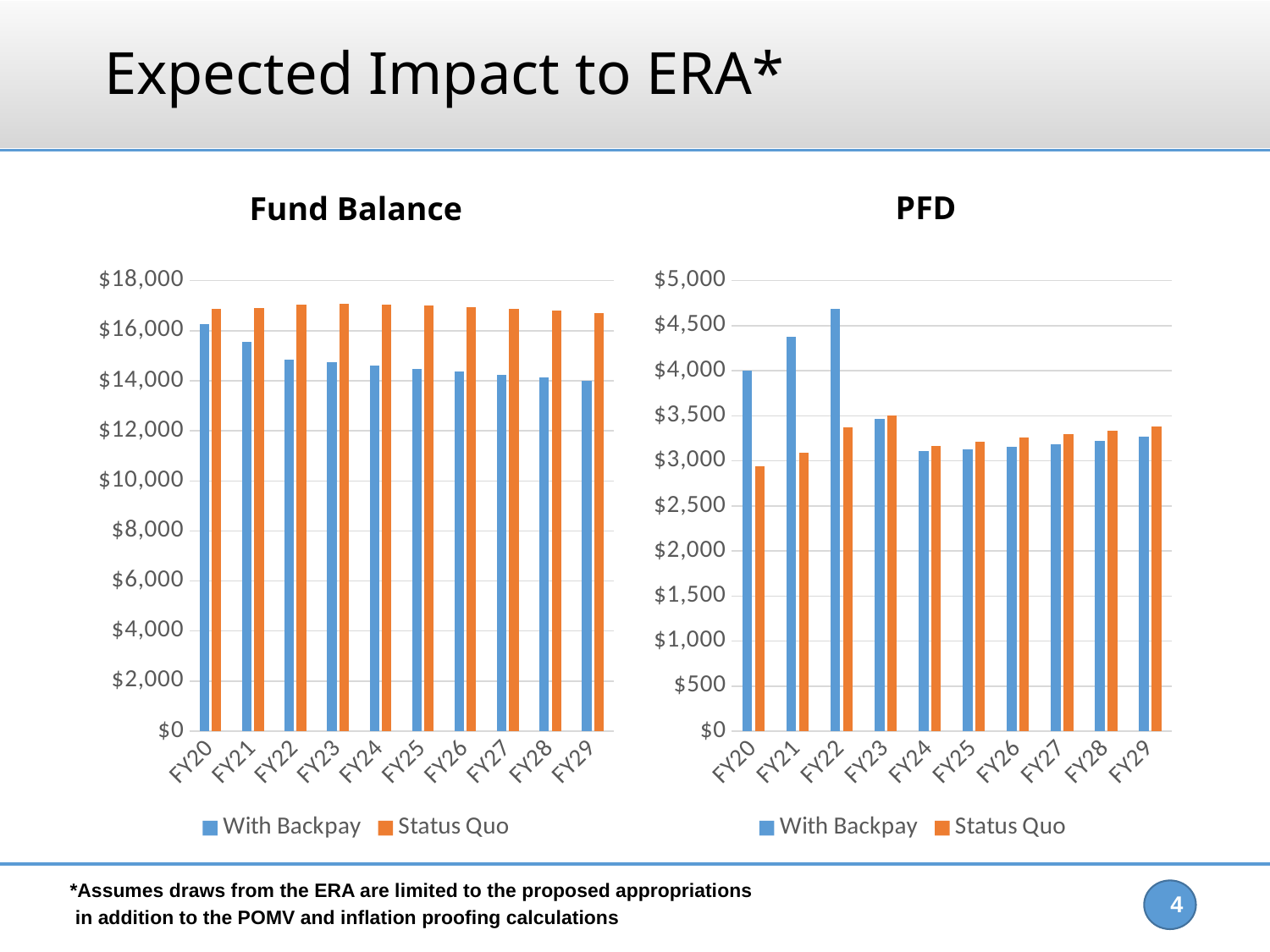
In the Fund Balance chart, do the With Backpay values rise or fall from FY20 to FY29? fall In the PFD chart, which fiscal year has the lowest Status Quo value? FY20 What kind of chart is the Fund Balance chart? bar chart In the Fund Balance chart, which series is larger in FY25, With Backpay or Status Quo? Status Quo In the PFD chart, is the Status Quo value for FY20 greater or less than $3,000? less In the Fund Balance chart, which fiscal year has the highest With Backpay value? FY20 In the Fund Balance chart, is the Status Quo value for FY23 greater or less than $16,000? greater In the PFD chart, which fiscal year has the highest With Backpay value? FY22 In the PFD chart, which series is larger in FY20, With Backpay or Status Quo? With Backpay How many fiscal years are shown on the x axis of the Fund Balance chart? 10 How many series does the legend of the PFD chart list? 2 In the Fund Balance chart, is the With Backpay value for FY21 greater or less than $16,000? less